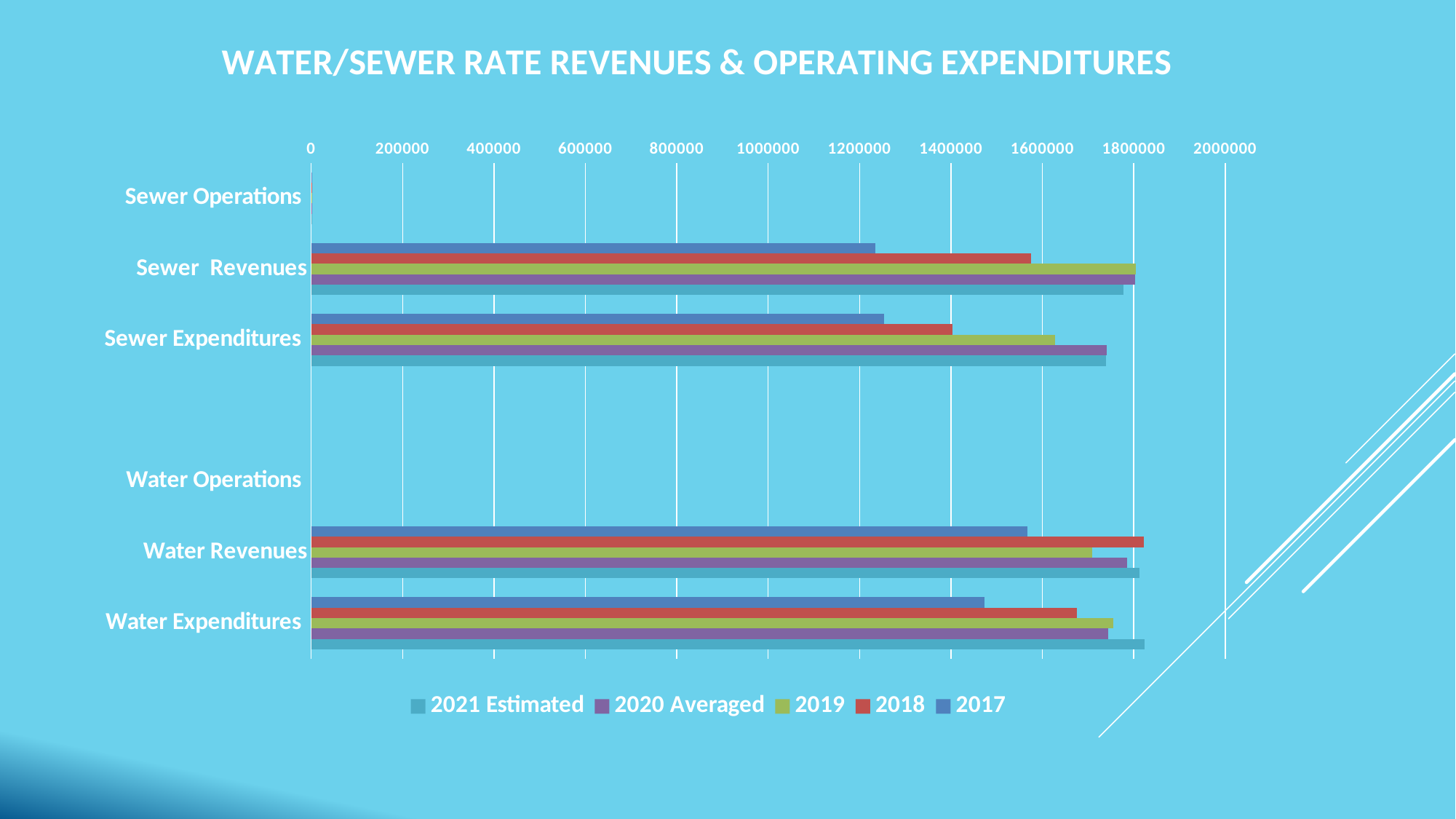
Which series has the lowest value for Water Expenditures? 2017 What kind of chart is shown on the slide? bar chart Is the 2017 value for Water Revenues greater or less than 1400000? greater What is the title of the chart? WATER/SEWER RATE REVENUES & OPERATING EXPENDITURES For Sewer Revenues, which is larger: the 2017 value or the 2018 value? 2018 Which series has the highest value for Water Expenditures? 2021 Estimated For Sewer Expenditures, which is larger: the 2017 value or the 2020 Averaged value? 2020 Averaged Which series has the lowest value for Sewer Revenues? 2017 How many series does the legend list? 5 Is the 2017 value for Sewer Revenues greater or less than 1400000? less Is the 2017 value for Water Expenditures greater or less than 1600000? less